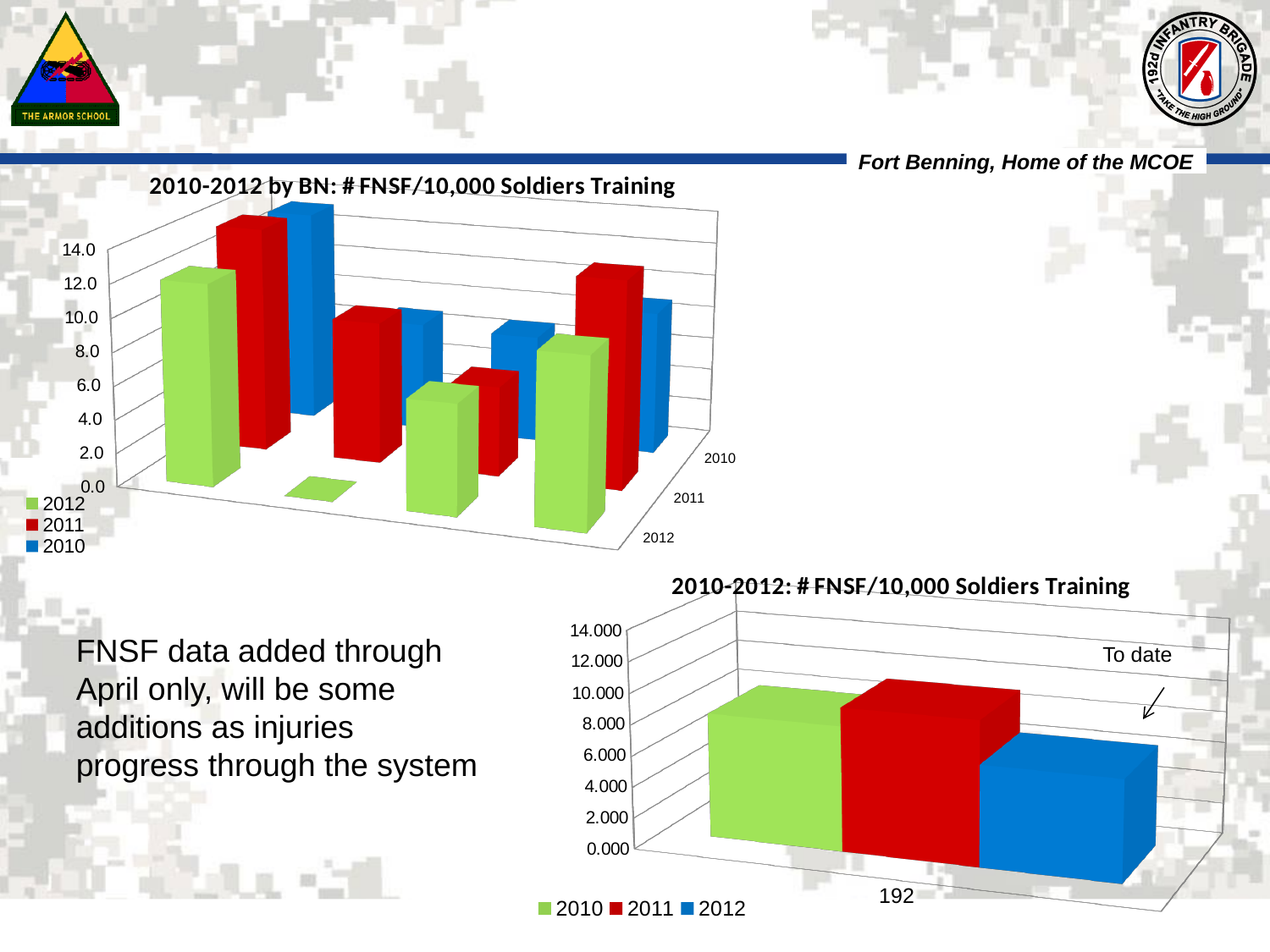
In the bottom chart "2010-2012: # FNSF/10,000 Soldiers Training", is the value for 2012 greater or less than 10.000? less In the bottom chart "2010-2012: # FNSF/10,000 Soldiers Training", which year has the lowest value? 2012 How many series does the legend of the bottom chart "2010-2012: # FNSF/10,000 Soldiers Training" list? 3 How many category groups of bars are plotted in the top chart "2010-2012 by BN: # FNSF/10,000 Soldiers Training"? 4 In the bottom chart "2010-2012: # FNSF/10,000 Soldiers Training", which year has the highest value? 2011 In the bottom chart "2010-2012: # FNSF/10,000 Soldiers Training", which is larger, the value for 2010 or the value for 2012? 2010 How many series does the legend of the top chart "2010-2012 by BN: # FNSF/10,000 Soldiers Training" list? 3 In the bottom chart "2010-2012: # FNSF/10,000 Soldiers Training", is the value for 2011 greater or less than 8.000? greater What category label appears on the x axis of the bottom chart "2010-2012: # FNSF/10,000 Soldiers Training"? 192 In the top chart "2010-2012 by BN: # FNSF/10,000 Soldiers Training", which colour represents the 2011 series? Red What kind of chart is the bottom chart titled "2010-2012: # FNSF/10,000 Soldiers Training"? Bar chart What kind of chart is the top chart titled "2010-2012 by BN: # FNSF/10,000 Soldiers Training"? Bar chart